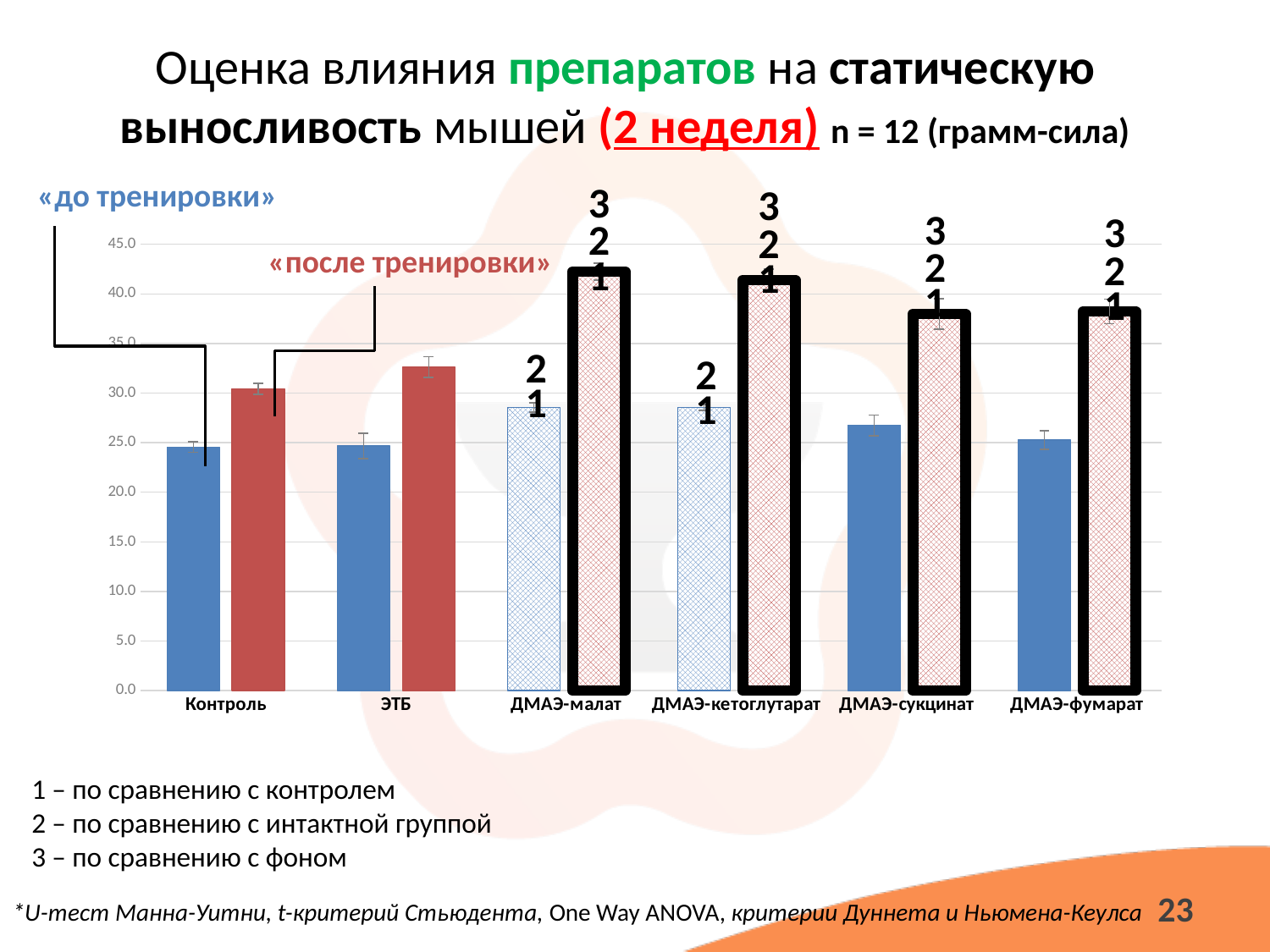
Is the «после тренировки» value for ДМАЭ-малат greater or less than 40.0? greater Which is larger: the «после тренировки» value for ДМАЭ-малат or for ДМАЭ-сукцинат? ДМАЭ-малат What colour are the «до тренировки» bars for Контроль and ЭТБ? blue How many categories (groups) are shown along the x axis of the chart? 6 Is the «до тренировки» value for Контроль greater or less than 30.0? less Is the «после тренировки» value for ЭТБ greater or less than 30.0? greater How many data series does the chart show? 2 What are the two series shown in the chart called? «до тренировки» and «после тренировки» What kind of chart is shown on the slide? bar chart Which group has the lowest «после тренировки» value? Контроль